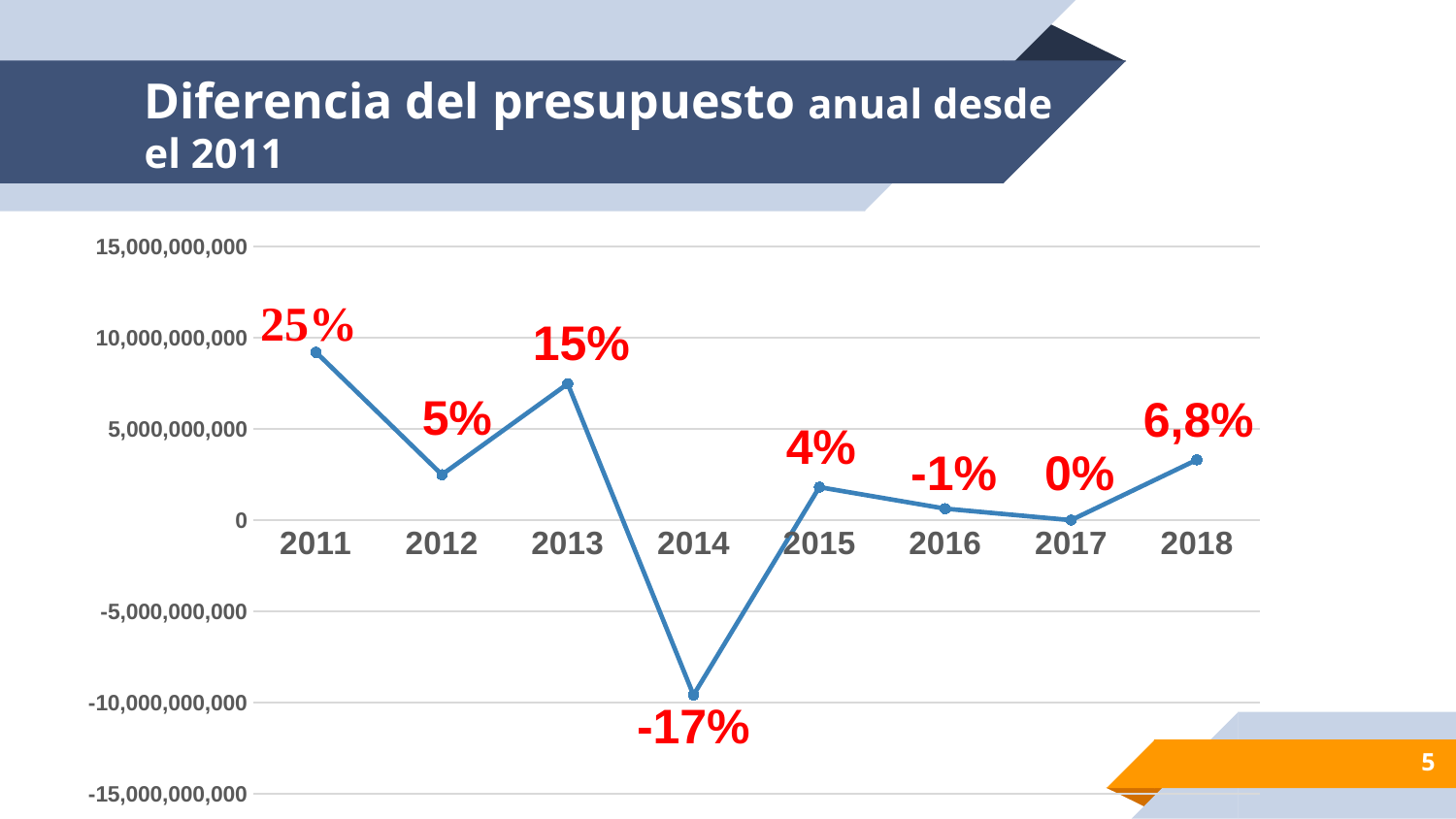
Which year has the lowest value on the line? 2014 Which is larger, the value for 2012 or the value for 2013? 2013 What kind of chart is shown on the slide? line chart Which year has the highest value on the line? 2011 How many years are plotted on the x axis? 8 Does the line rise or fall from 2011 to 2012? fall Is the value for 2011 greater or less than 5,000,000,000? greater What percentage label is shown for 2011? 25% What percentage label is shown for 2014? -17% What percentage label is shown for 2017? 0% What percentage label is shown for 2018? 6,8% Is the value for 2014 greater or less than -5,000,000,000? less